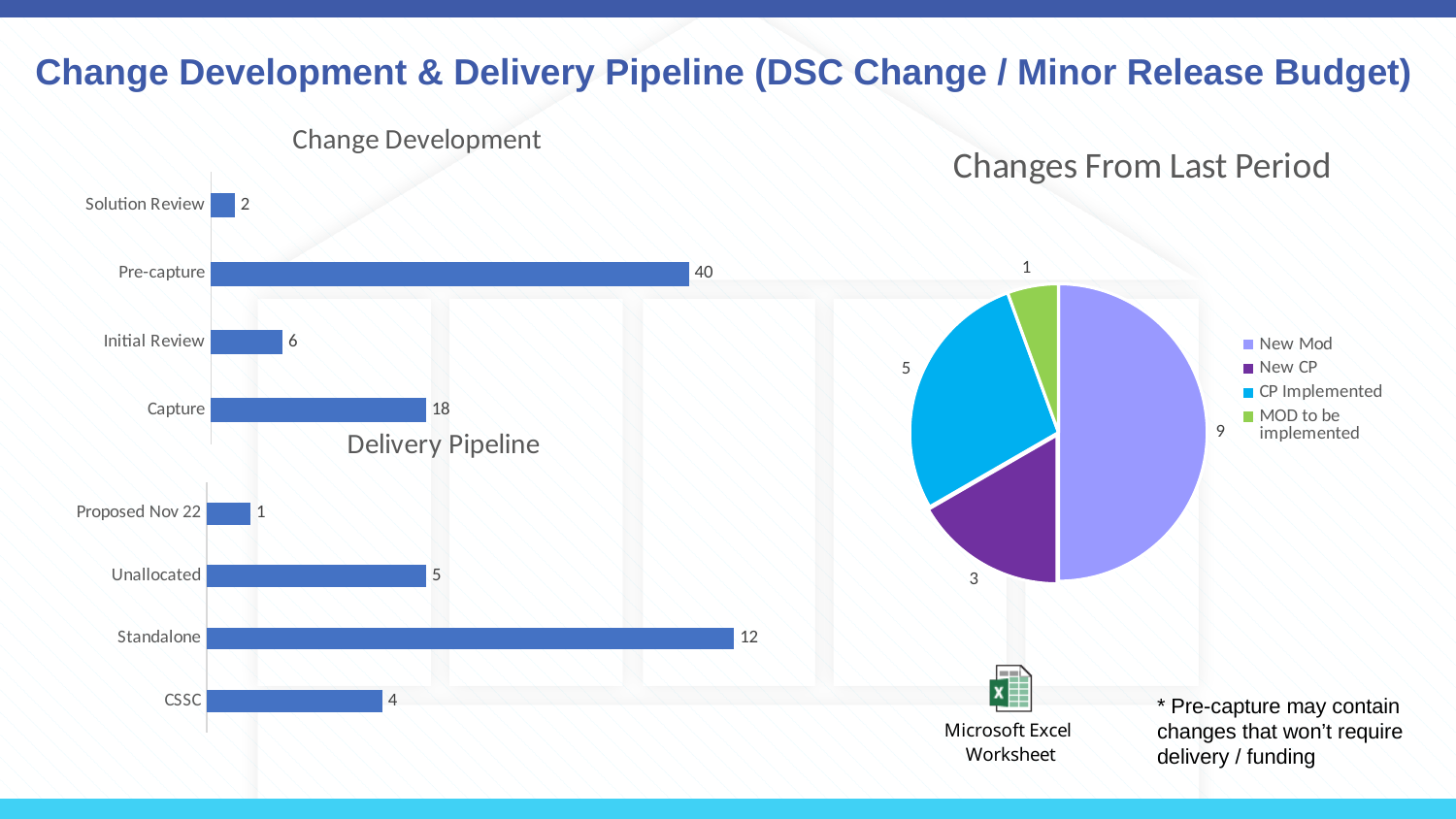
In the Change Development chart, what is the value for Pre-capture? 40 In the Delivery Pipeline chart, which category has the highest value? Standalone In the Delivery Pipeline chart, what is the value for Standalone? 12 How many entries does the legend of the Changes From Last Period chart list? 4 In the Change Development chart, which category has the lowest value? Solution Review In the Change Development chart, what is the value for Capture? 18 How many categories does the Delivery Pipeline chart show? 4 In the Changes From Last Period chart, what is the value for CP Implemented? 5 What kind of chart is the Changes From Last Period chart? Pie chart In the Change Development chart, what is the difference between Pre-capture and Capture? 22 In the Changes From Last Period chart, what share of the total does New Mod represent? 50% In the Delivery Pipeline chart, which is larger, Unallocated or CSSC? Unallocated